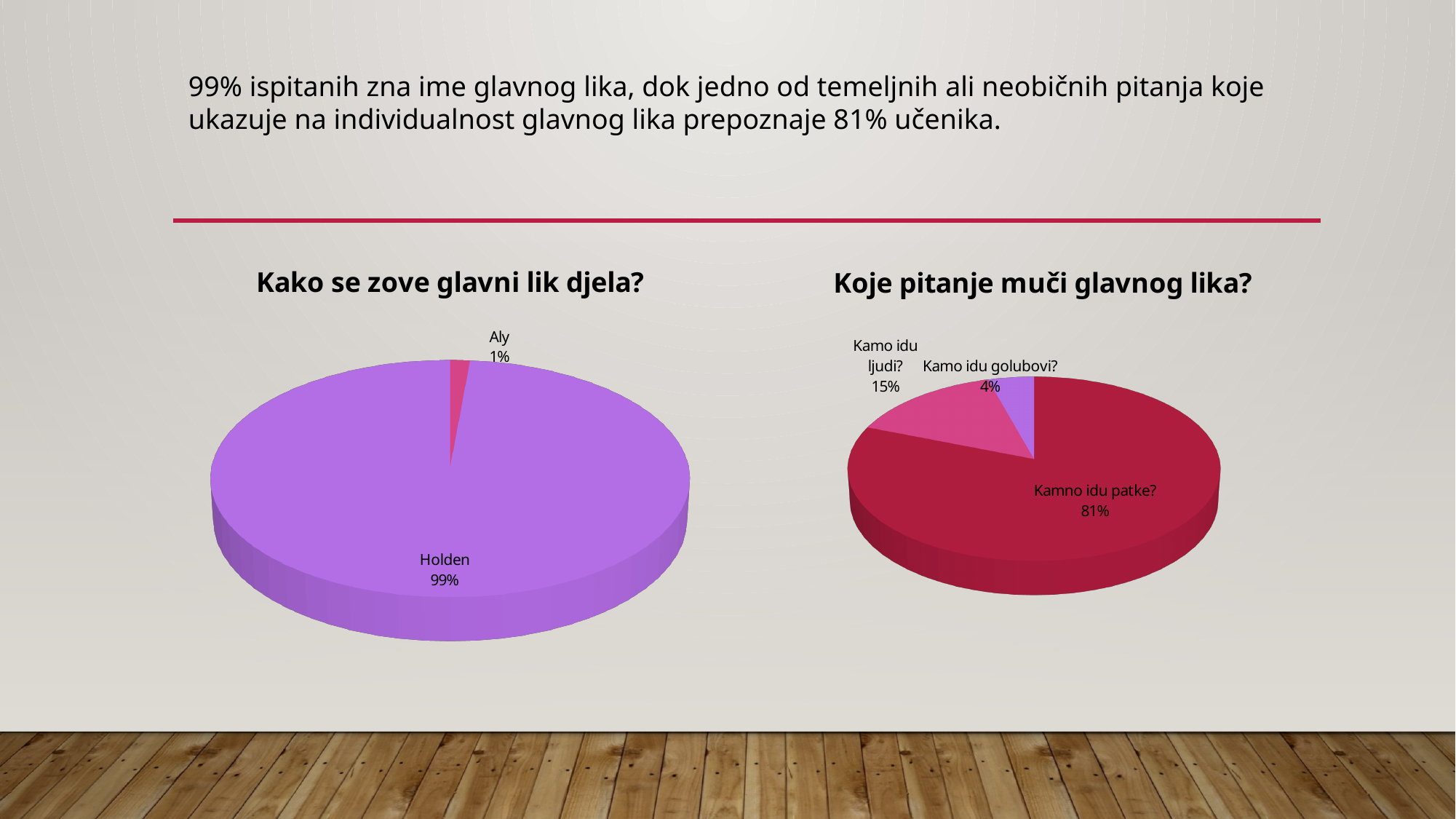
In the chart titled "Kako se zove glavni lik djela?", which slice is the largest? Holden In the chart titled "Koje pitanje muči glavnog lika?", what share of the pie does "Kamo idu golubovi?" have? 4% In the chart titled "Koje pitanje muči glavnog lika?", which slice is the smallest? Kamo idu golubovi? In the chart titled "Koje pitanje muči glavnog lika?", how many slices does the pie have? 3 What kind of chart is the chart titled "Kako se zove glavni lik djela?"? Pie chart In the chart titled "Kako se zove glavni lik djela?", what share of the pie does Holden have? 99% What is the title of the chart on the right side of the slide? Koje pitanje muči glavnog lika? In the chart titled "Koje pitanje muči glavnog lika?", what is the difference in percentage points between "Kamo idu ljudi?" and "Kamo idu golubovi?"? 11 percentage points In the chart titled "Koje pitanje muči glavnog lika?", what share of the pie does "Kamo idu ljudi?" have? 15% In the chart titled "Kako se zove glavni lik djela?", how many slices does the pie have? 2